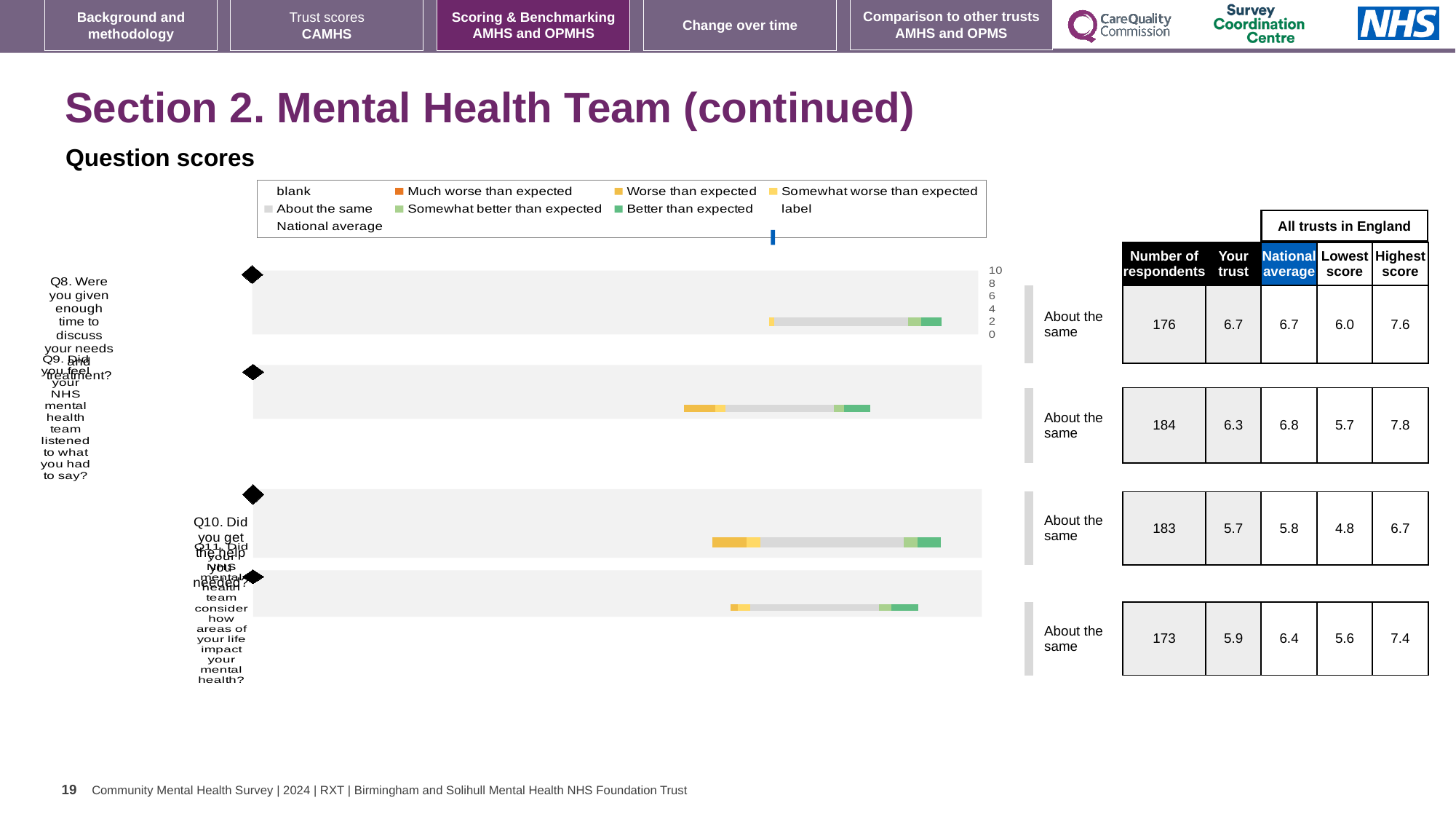
Which question has the highest number of respondents among Q8 to Q11? Q9 What is the difference between the national average (6.8) and the 'Your trust' score (6.3) for Q9? 0.5 How many question charts (Q8 to Q11) are shown on the slide? 4 In the legend, which colour represents 'Much worse than expected'? orange What kind of chart is used to show the question scores on this slide? bar chart For Q9, which is larger: the 'Your trust' score or the national average? national average What is the national average score shown for Q10 (Did you get the help you needed)? 5.8 Which question has the lowest 'Your trust' score among Q8 to Q11? Q10 What is the 'Your trust' score shown for Q9 (Did you feel your NHS mental health team listened to what you had to say)? 6.3 How many entries does the legend above the question score charts list? 9 What is the highest tick value shown on the score axis to the right of the charts? 10 What is the 'Your trust' score shown for Q8 (Were you given enough time to discuss your needs and treatment)? 6.7